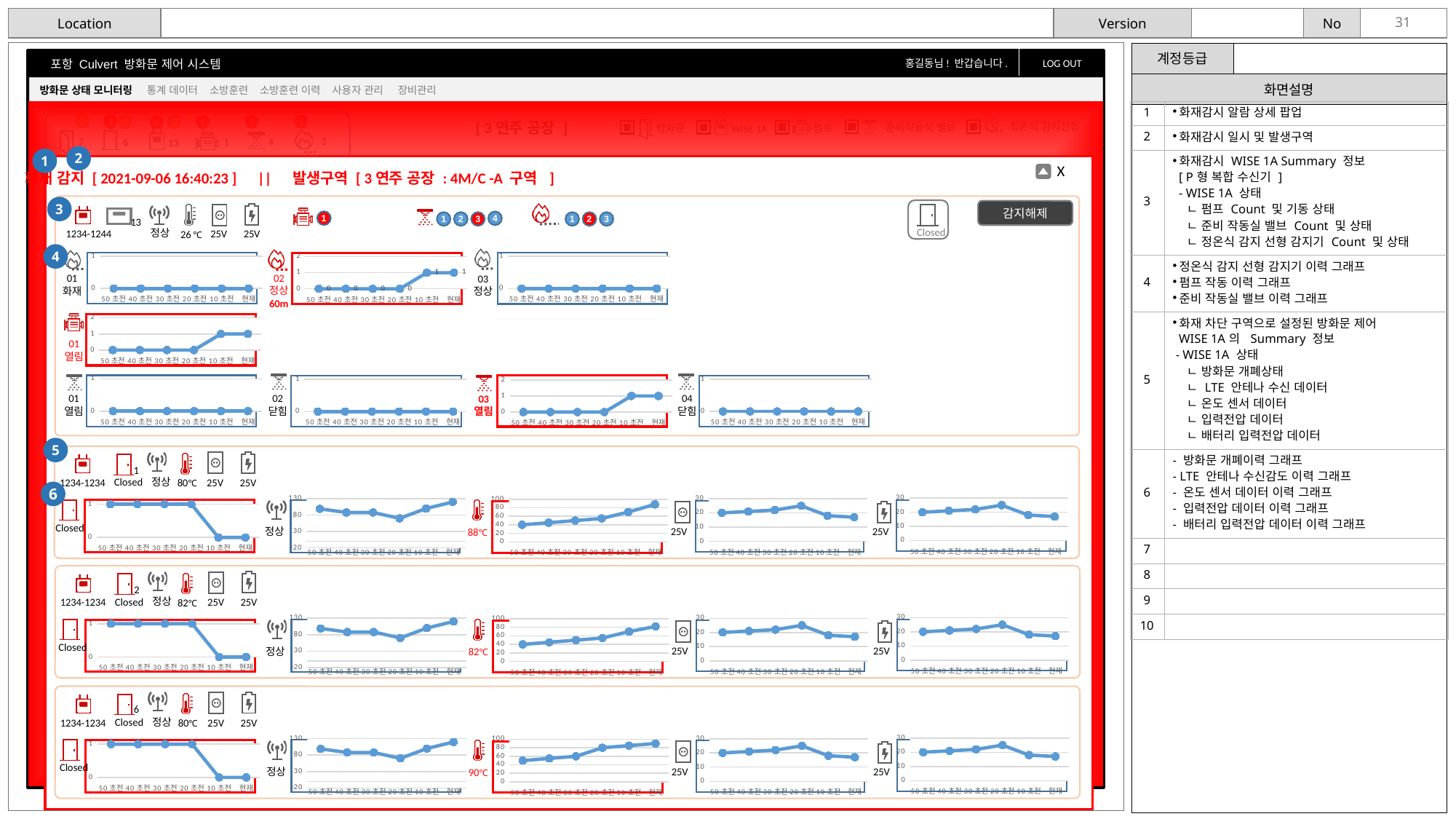
In the first '1234-1234' section, on the '정상' antenna chart, is the value at 현재 greater or less than 80? greater In the first '1234-1234' section, on the temperature chart labelled 88℃, is the value at 현재 greater or less than 60? greater On the '02 정상 60m' chart, what is the value at 50초전? 0 On the '01 화재' chart (first chart in the top row of the detection panel), do the values rise, fall, or stay flat across the x axis? stay flat On the '02 정상 60m' chart, what is the value at 현재? 1 On the '02 정상 60m' chart, do the values rise or fall from 50초전 to 현재? rise In the first '1234-1234' section, on the temperature chart labelled 88℃, is the value at 50초전 greater or less than 60? less How many data points are plotted on the '02 정상 60m' line chart? 6 On the '03 열림' sprinkler chart, what is the highest y-axis tick shown? 2 What kind of chart is the '02 정상 60m' graph in the top row of the detection panel? line chart In the first '1234-1234' section, on the 'Closed' door chart, do the values rise or fall from 50초전 to 현재? fall What is the last x-axis label shown on the line charts? 현재